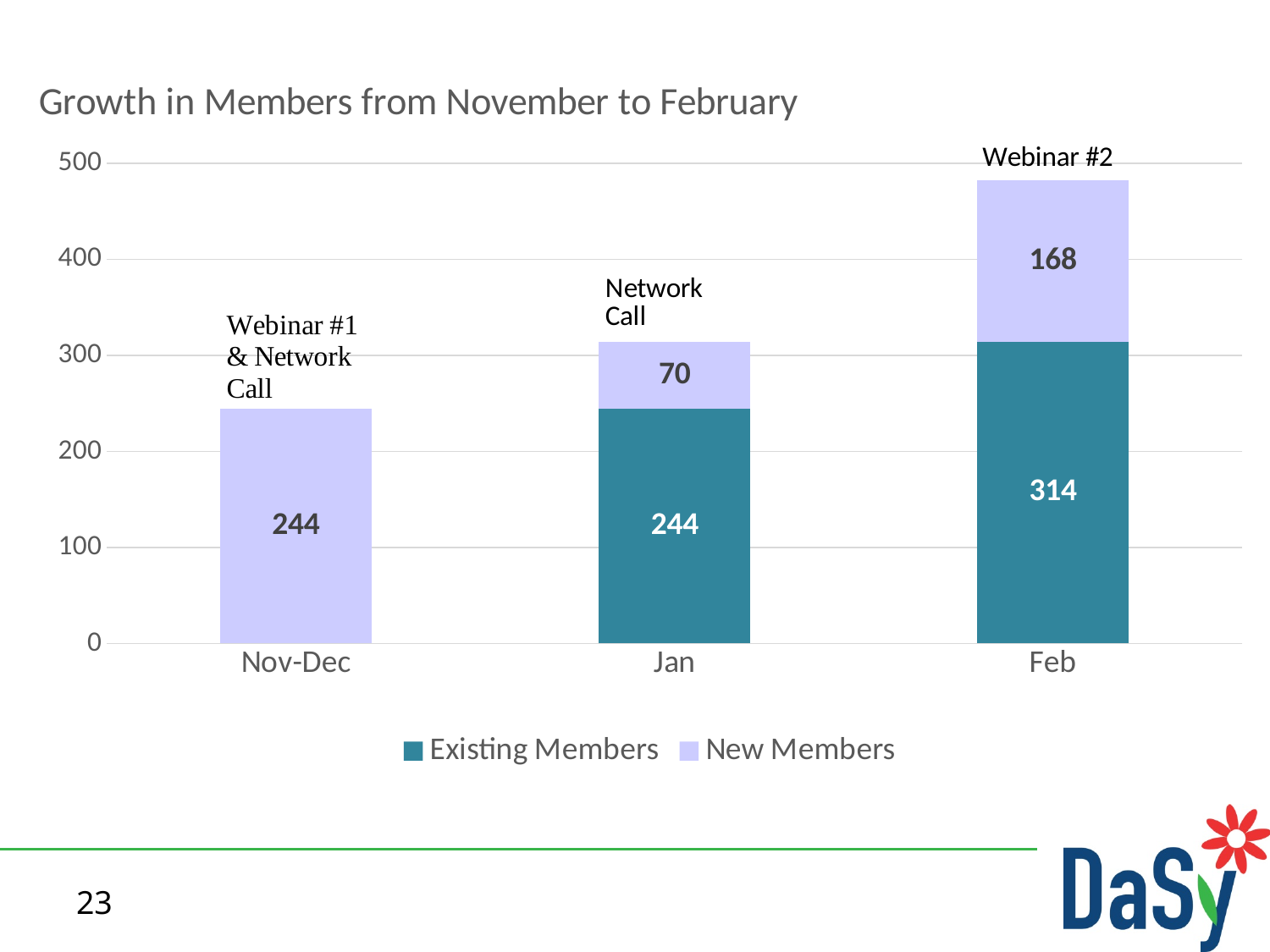
What is the total of the stacked bar for Feb? 482 Which month has the highest total bar? Feb What is the value for Existing Members in Jan? 244 What type of chart is shown on the slide? Stacked bar chart Do the total bar heights rise or fall from Nov-Dec to Feb? Rise How many series does the legend list? 2 How many categories are shown on the x axis? 3 What is the difference between New Members in Feb and New Members in Jan? 98 What is the title of the chart? Growth in Members from November to February What is the value for New Members in Nov-Dec? 244 What is the total of the stacked bar for Jan? 314 What is the value for New Members in Feb? 168